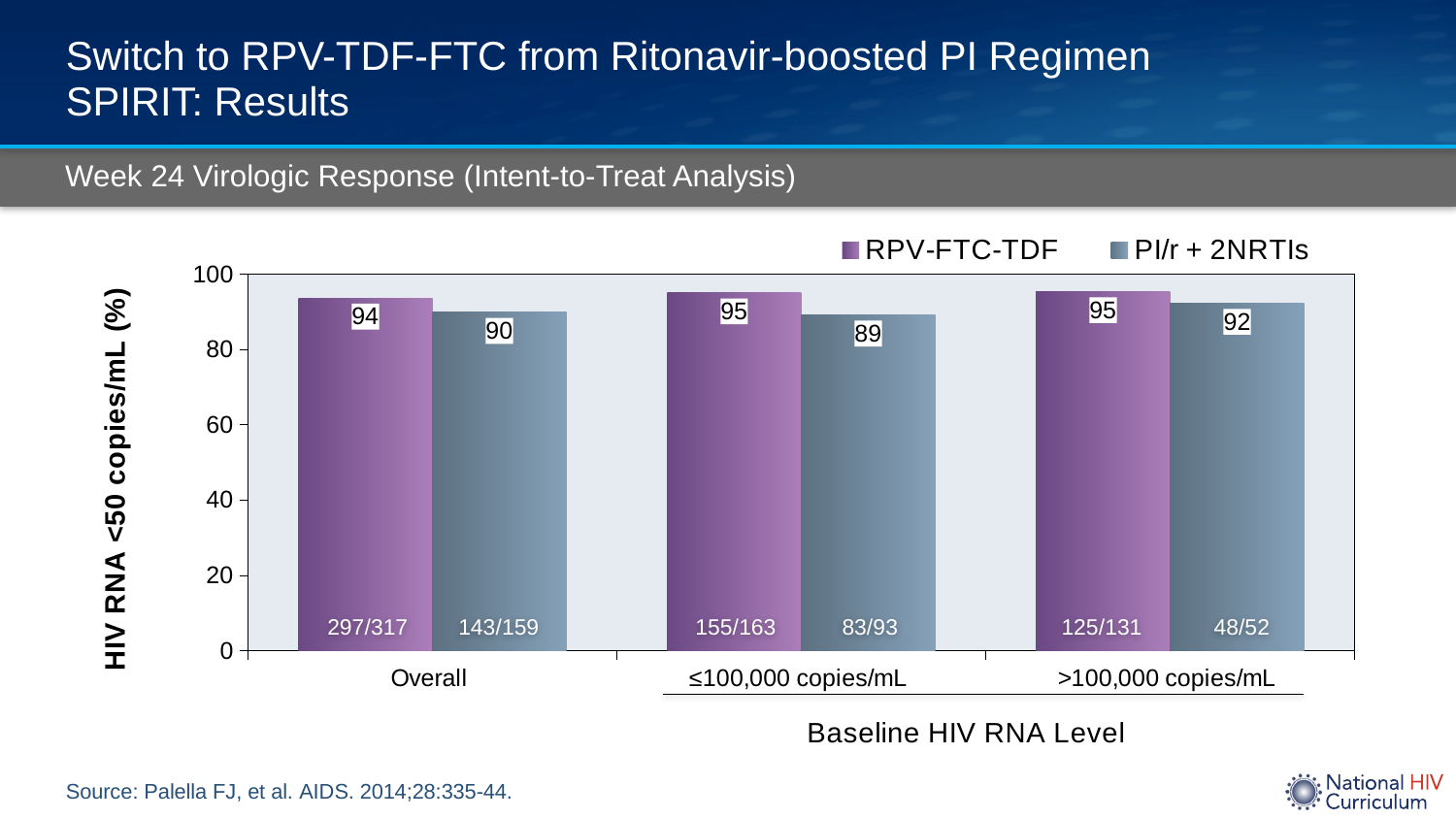
What is the difference between the RPV-FTC-TDF and PI/r + 2NRTIs values in the ≤100,000 copies/mL category? 6 What is the value for RPV-FTC-TDF in the Overall category? 94 What is the value for PI/r + 2NRTIs in the ≤100,000 copies/mL category? 89 What is the difference between the RPV-FTC-TDF and PI/r + 2NRTIs values in the Overall category? 4 How many series does the legend list? 2 What is the label of the y axis? HIV RNA <50 copies/mL (%) In the >100,000 copies/mL category, which series has the larger value, RPV-FTC-TDF or PI/r + 2NRTIs? RPV-FTC-TDF How many categories are shown on the x axis? 3 What is the value for PI/r + 2NRTIs in the >100,000 copies/mL category? 92 Is the value for PI/r + 2NRTIs in the Overall category greater or less than 80? greater Which category has the lowest value for PI/r + 2NRTIs? ≤100,000 copies/mL What kind of chart is shown on the slide? Bar chart